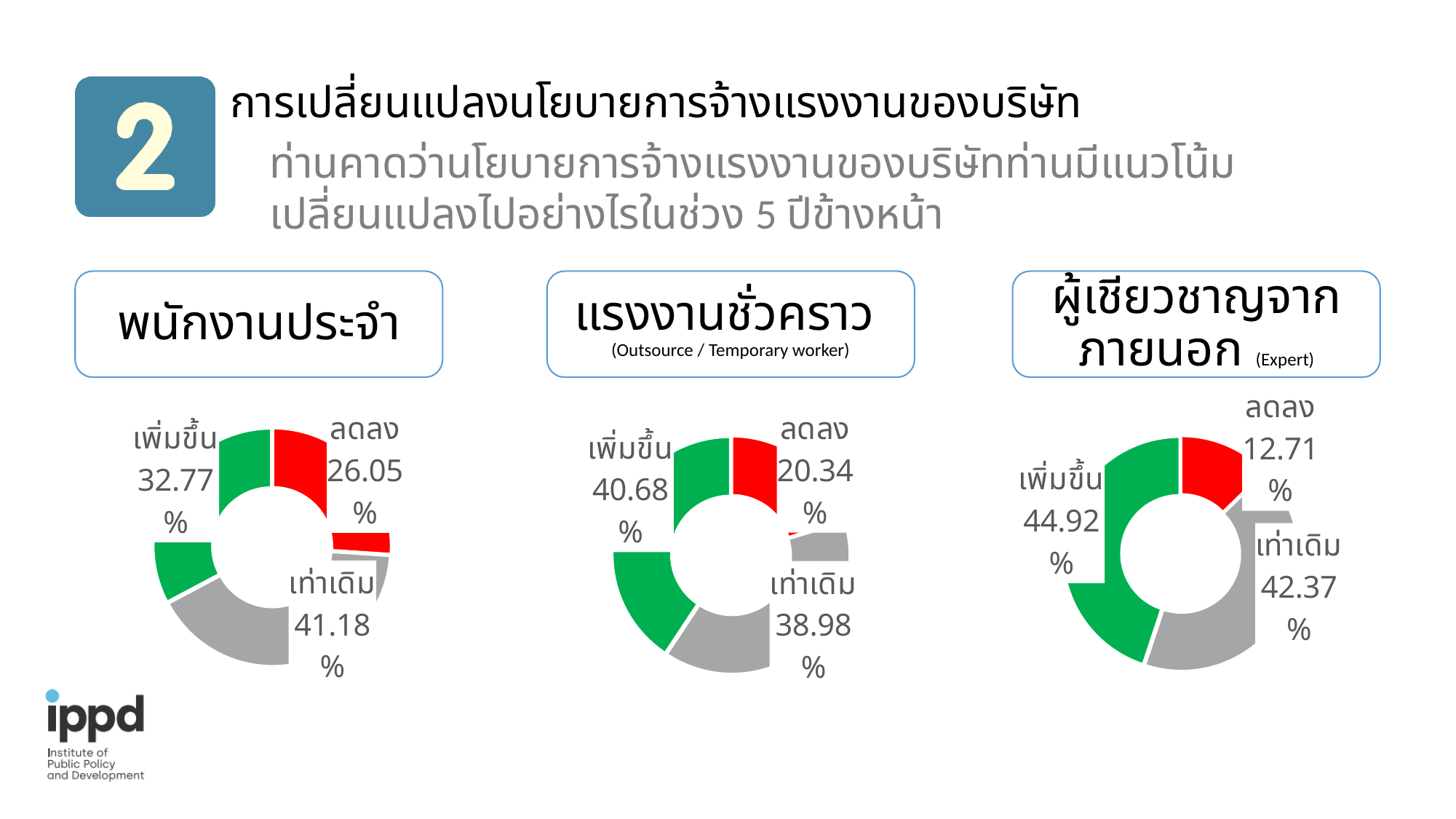
In the พนักงานประจำ chart, which category has the largest share? เท่าเดิม In the ผู้เชี่ยวชาญจากภายนอก (Expert) chart, what colour is the ลดลง slice? Red In the ผู้เชี่ยวชาญจากภายนอก (Expert) chart, what percentage is shown for ลดลง? 12.71% In the แรงงานชั่วคราว (Outsource / Temporary worker) chart, what percentage is shown for เพิ่มขึ้น? 40.68% In the พนักงานประจำ chart, what percentage is shown for เท่าเดิม? 41.18% In the พนักงานประจำ chart, what is the difference between the เท่าเดิม and ลดลง percentages? 15.13% What kind of chart is used for แรงงานชั่วคราว (Outsource / Temporary worker)? Donut (pie) chart In the ผู้เชี่ยวชาญจากภายนอก (Expert) chart, which category has the largest share? เพิ่มขึ้น In the แรงงานชั่วคราว (Outsource / Temporary worker) chart, which category has the smallest share? ลดลง In the ผู้เชี่ยวชาญจากภายนอก (Expert) chart, what is the difference between the เพิ่มขึ้น and ลดลง percentages? 32.21% In the แรงงานชั่วคราว (Outsource / Temporary worker) chart, which is larger: เพิ่มขึ้น or เท่าเดิม? เพิ่มขึ้น How many slices does the พนักงานประจำ chart have? 3